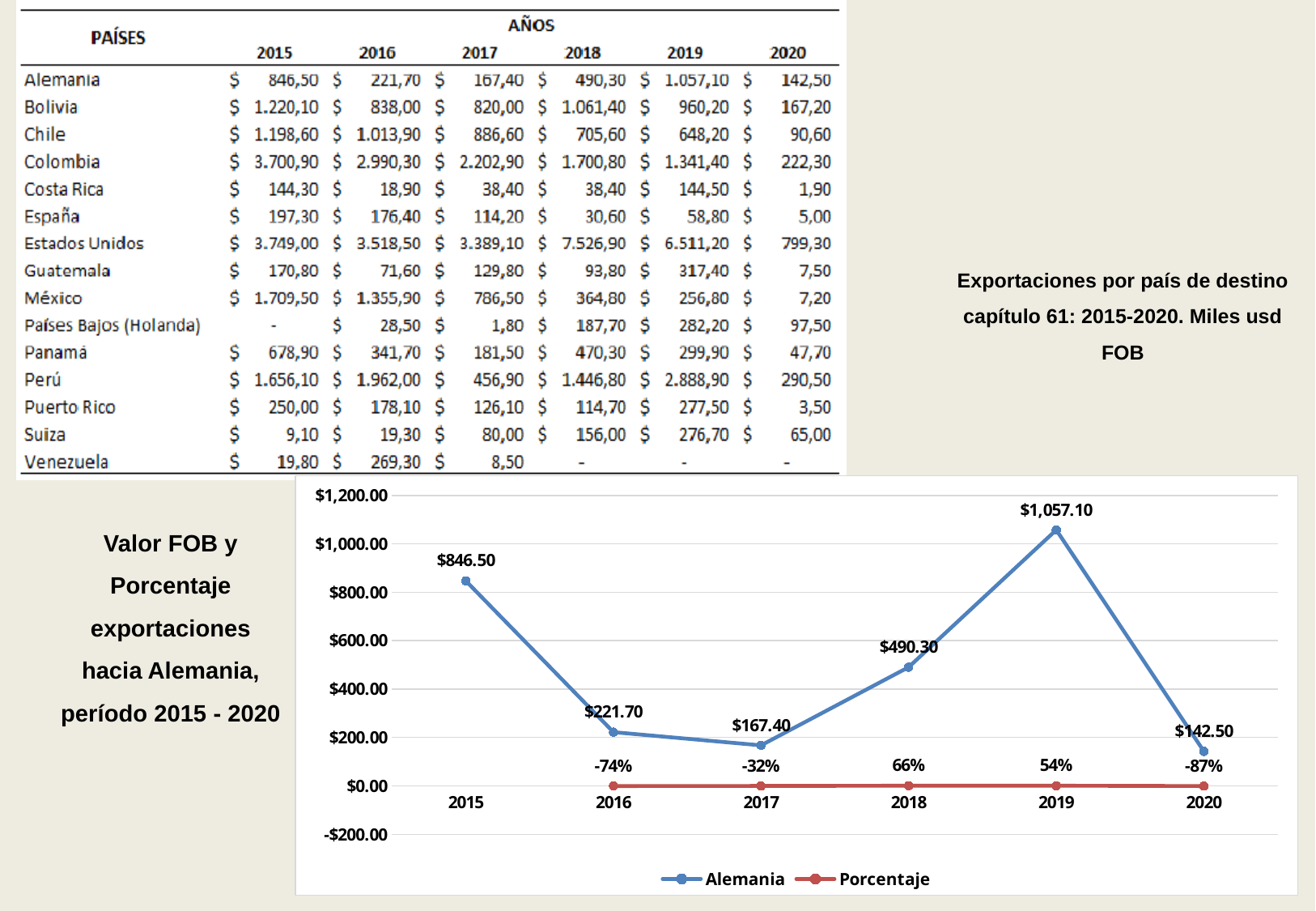
What is the Alemania value for 2019? $1,057.10 In which year is the Alemania value highest? 2019 What type of chart is shown on the slide? line chart Which is larger, the Alemania value for 2016 or for 2017? 2016 How many years are plotted on the x axis? 6 What is the Porcentaje value for 2018? 66% What is the Alemania value for 2015? $846.50 How many series does the legend list? 2 Does the Alemania value rise or fall from 2015 to 2017? fall In which year is the Alemania value lowest? 2020 What is the difference between the Alemania values for 2019 and 2018? $566.80 What is the Porcentaje value for 2016? -74%